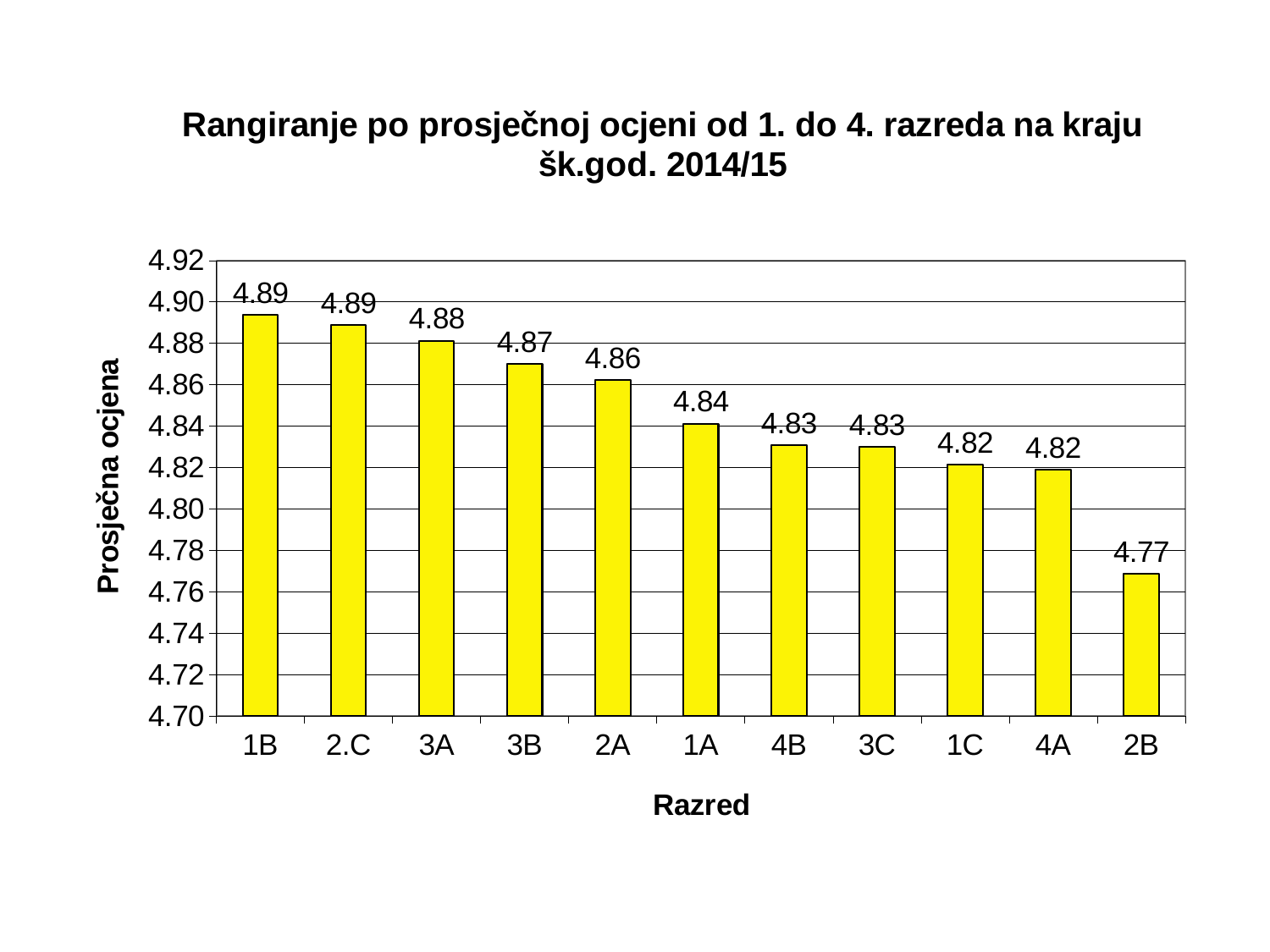
Which class has the lowest average grade? 2B What is the average grade (prosječna ocjena) shown for class 3A? 4.88 How many classes are shown on the x axis? 11 What value is shown for class 2B? 4.77 What is the difference between the value for 1B and the value for 2B? 0.12 What is the difference between the value for 3A and the value for 1A? 0.04 What kind of chart is this? bar chart Which has a higher value, 3B or 4A? 3B Is the value for 2B greater or less than 4.80? less What is the title of the y axis? Prosječna ocjena What is the value shown for class 1A? 4.84 Do the values rise or fall from left to right along the x axis? fall